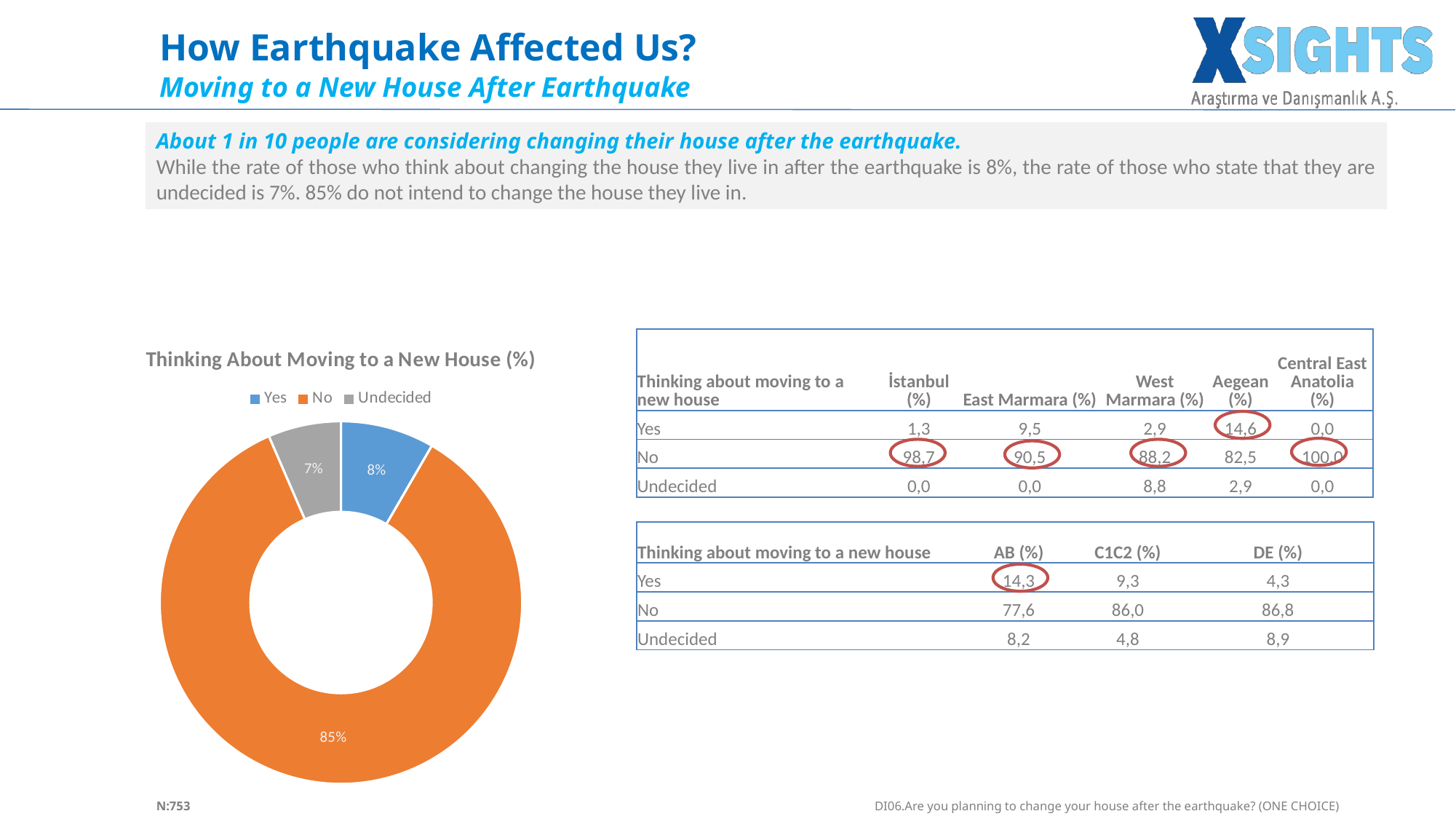
How many slices does the chart 'Thinking About Moving to a New House (%)' have? 3 In the chart 'Thinking About Moving to a New House (%)', what is the difference between the 'No' and 'Yes' values? 77% In the chart 'Thinking About Moving to a New House (%)', is the share for 'Yes' larger or smaller than the share for 'Undecided'? Larger In the chart 'Thinking About Moving to a New House (%)', what is the value for 'No'? 85% What type of chart is 'Thinking About Moving to a New House (%)'? Doughnut chart In the chart 'Thinking About Moving to a New House (%)', what is the combined share of 'Yes' and 'Undecided'? 15% In the chart 'Thinking About Moving to a New House (%)', which category has the largest share? No In the chart 'Thinking About Moving to a New House (%)', which category has the smallest share? Undecided In the chart 'Thinking About Moving to a New House (%)', what is the value for 'Yes'? 8% In the chart 'Thinking About Moving to a New House (%)', what colour is the 'No' slice? Orange In the chart 'Thinking About Moving to a New House (%)', what is the value for 'Undecided'? 7% How many categories does the legend of 'Thinking About Moving to a New House (%)' list? 3